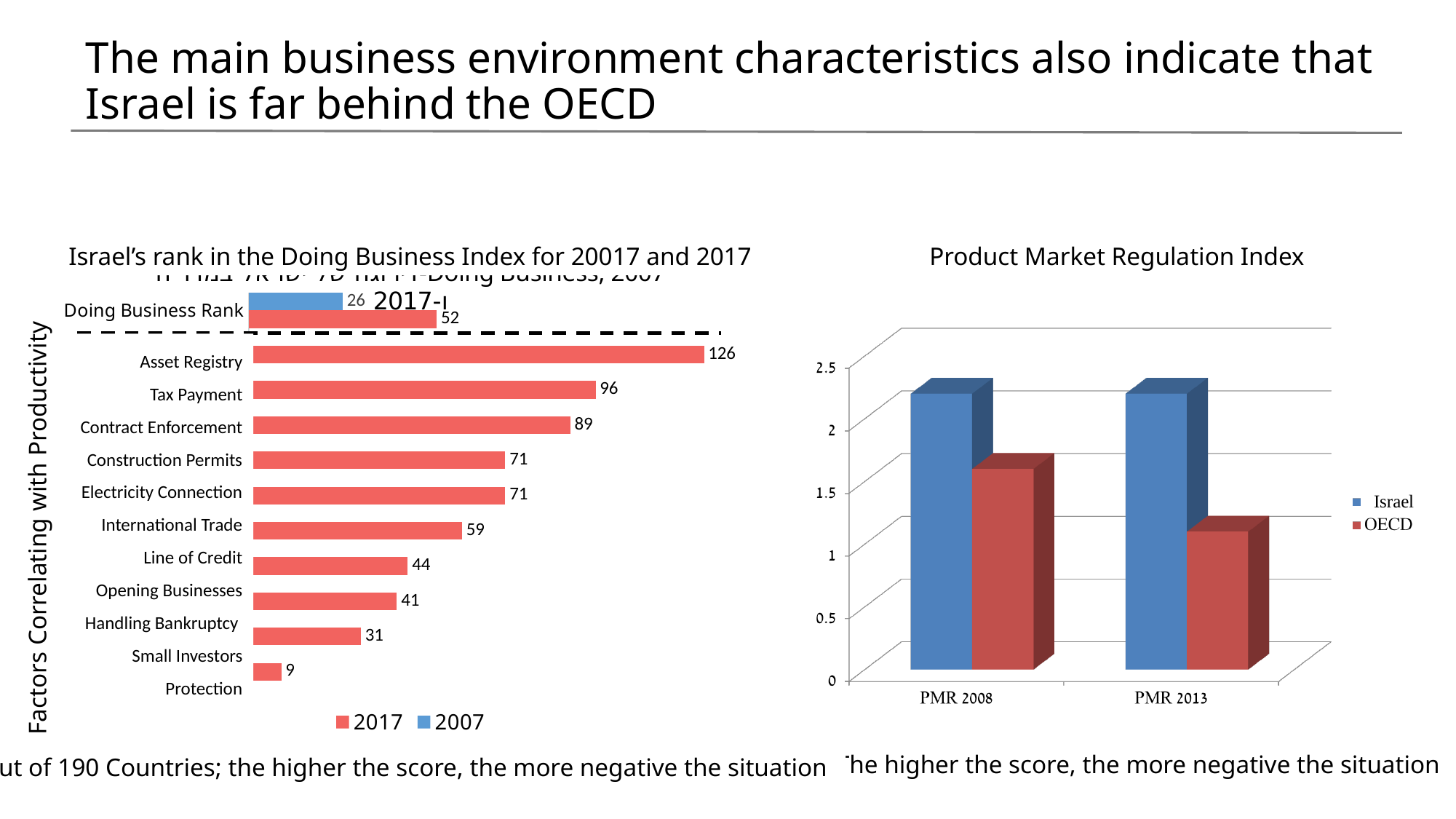
On the Doing Business Index chart, what is the difference between the Tax Payment rank and the Contract Enforcement rank in 2017? 7 On the Doing Business Index chart, what was the Doing Business Rank in 2007? 26 On the Doing Business Index chart, which factor has the lowest 2017 rank value? Small Investors Protection On the Doing Business Index chart, how many series does the legend list? 2 On the Doing Business Index chart, which factor has the highest 2017 rank value? Asset Registry On the Product Market Regulation Index chart, is the value for OECD in PMR 2013 greater or less than 1.5? less On the Doing Business Index chart, what is Israel's rank for Asset Registry in 2017? 126 On the Product Market Regulation Index chart, which is larger in PMR 2013: Israel or OECD? Israel What kind of chart is the Product Market Regulation Index chart? Bar chart On the Product Market Regulation Index chart, is the value for Israel in PMR 2008 greater or less than 2? greater On the Doing Business Index chart, which is larger in 2017: the rank for International Trade or for Line of Credit? International Trade On the Doing Business Index chart, what is the Doing Business Rank for 2017? 52